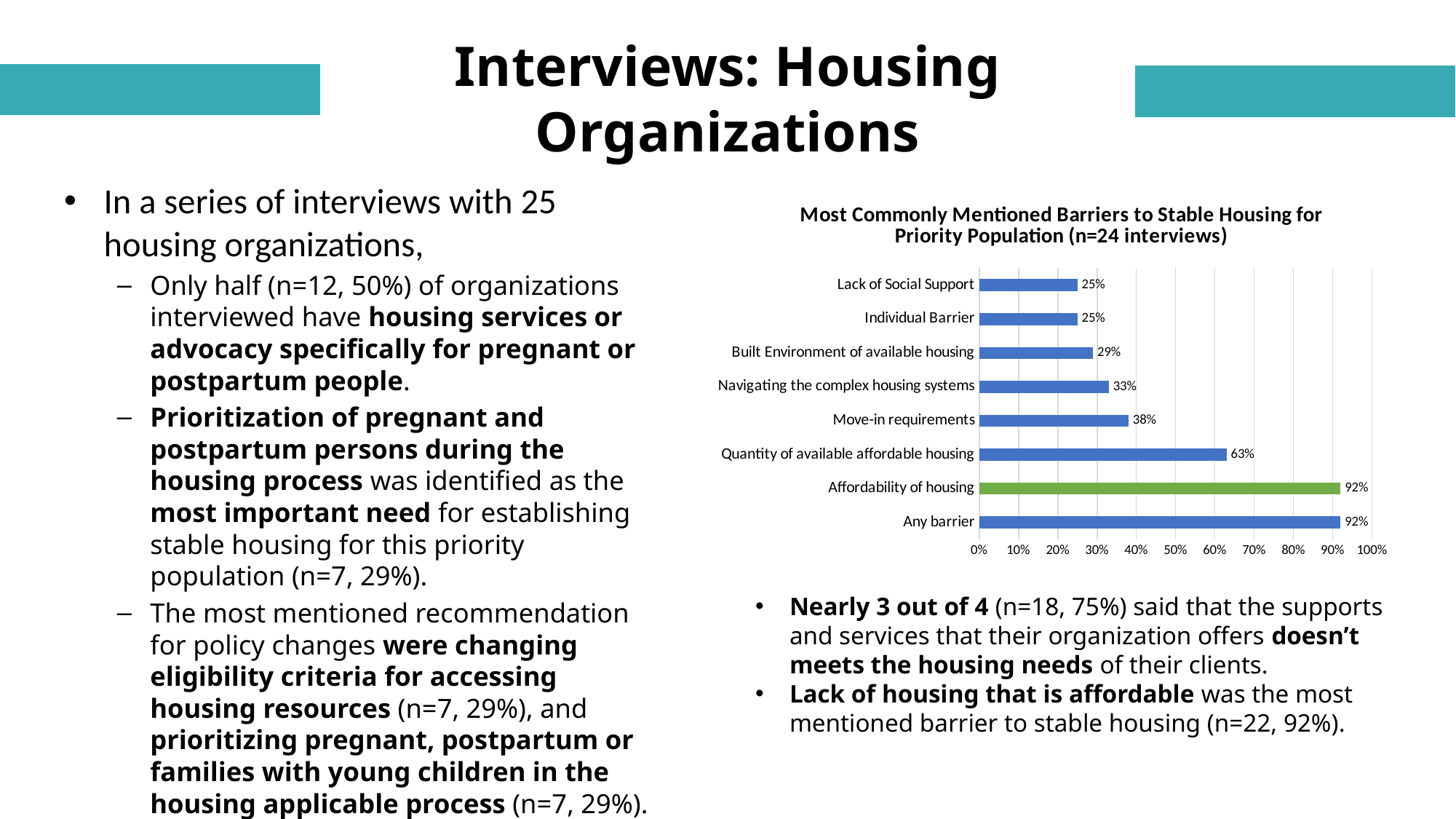
Which bar in the chart is coloured green? Affordability of housing What is the difference between the values for Affordability of housing and Quantity of available affordable housing? 29% How many categories are shown in the chart? 8 What is the value for Quantity of available affordable housing? 63% Which category has the lowest value, Lack of Social Support or Move-in requirements? Lack of Social Support What is the value for Built Environment of available housing? 29% What kind of chart is shown on the slide? bar chart What is the value for Move-in requirements? 38% What is the title of the chart? Most Commonly Mentioned Barriers to Stable Housing for Priority Population (n=24 interviews) What is the difference between the values for Quantity of available affordable housing and Move-in requirements? 25% Is the value for Quantity of available affordable housing greater or less than 50%? greater What is the value for Navigating the complex housing systems? 33%